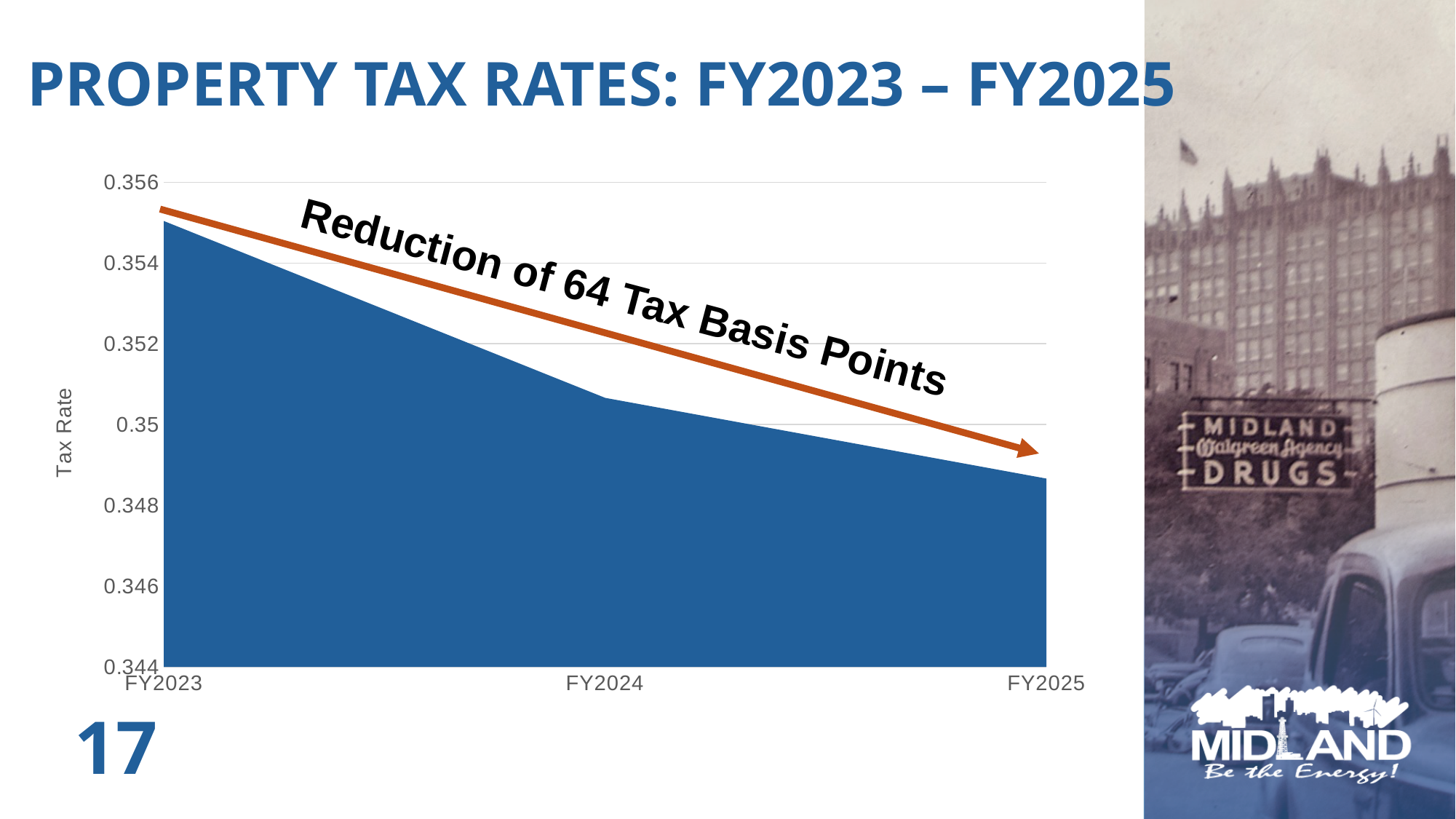
Is the tax rate for FY2025 greater or less than 0.348? greater Is the tax rate for FY2023 greater or less than 0.354? greater Is the tax rate for FY2025 greater or less than 0.35? less What does the annotation with the arrow on the chart say? Reduction of 64 Tax Basis Points How many fiscal years are plotted on the x axis? 3 Which is larger, the tax rate for FY2023 or for FY2025? FY2023 What kind of chart is shown on the slide? Area chart Which fiscal year has the highest tax rate? FY2023 What is the title of the slide's chart? PROPERTY TAX RATES: FY2023 – FY2025 Does the tax rate rise or fall from FY2023 to FY2025? Fall Which fiscal year has the lowest tax rate? FY2025